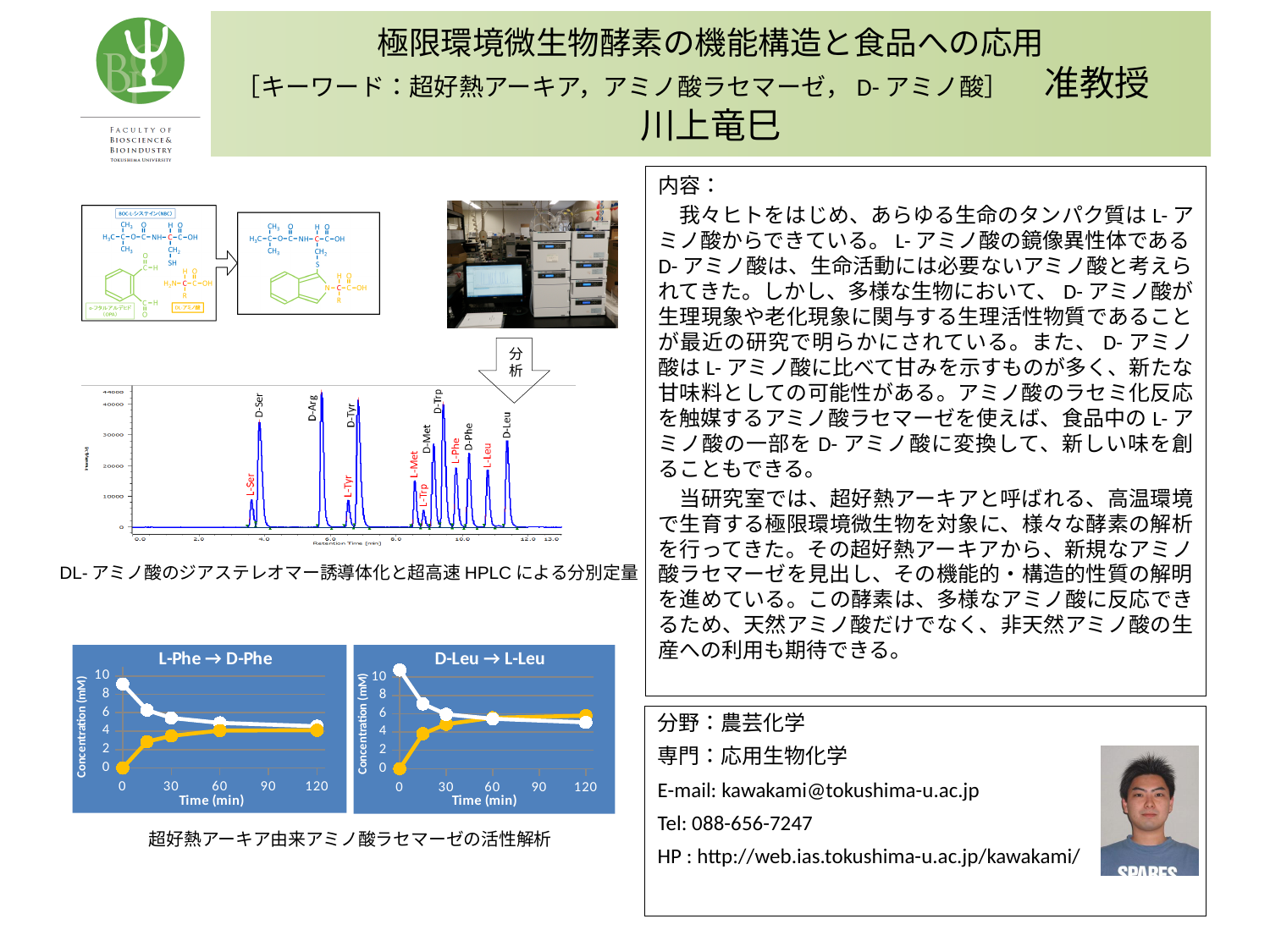
In the "L-Phe → D-Phe" chart, is the value of the white series at 120 min greater or less than 6? less In the "D-Leu → L-Leu" chart, is the value of the yellow series at 120 min greater or less than 4? greater In the "D-Leu → L-Leu" chart, does the yellow series rise or fall as time increases? rise What is the y-axis label of the "L-Phe → D-Phe" chart? Concentration (mM) How many tick labels are shown on the x axis of the "D-Leu → L-Leu" chart? 5 In the "L-Phe → D-Phe" chart, is the value of the white series at time 0 greater or less than 8? greater In the "L-Phe → D-Phe" chart, does the yellow series rise or fall as time increases? rise What is the x-axis label of the "D-Leu → L-Leu" chart? Time (min) In the "L-Phe → D-Phe" chart, does the white series rise or fall as time increases? fall What kind of chart is the "L-Phe → D-Phe" chart? line chart In the "L-Phe → D-Phe" chart, at time 0, which series has the larger value, the white series or the yellow series? white series